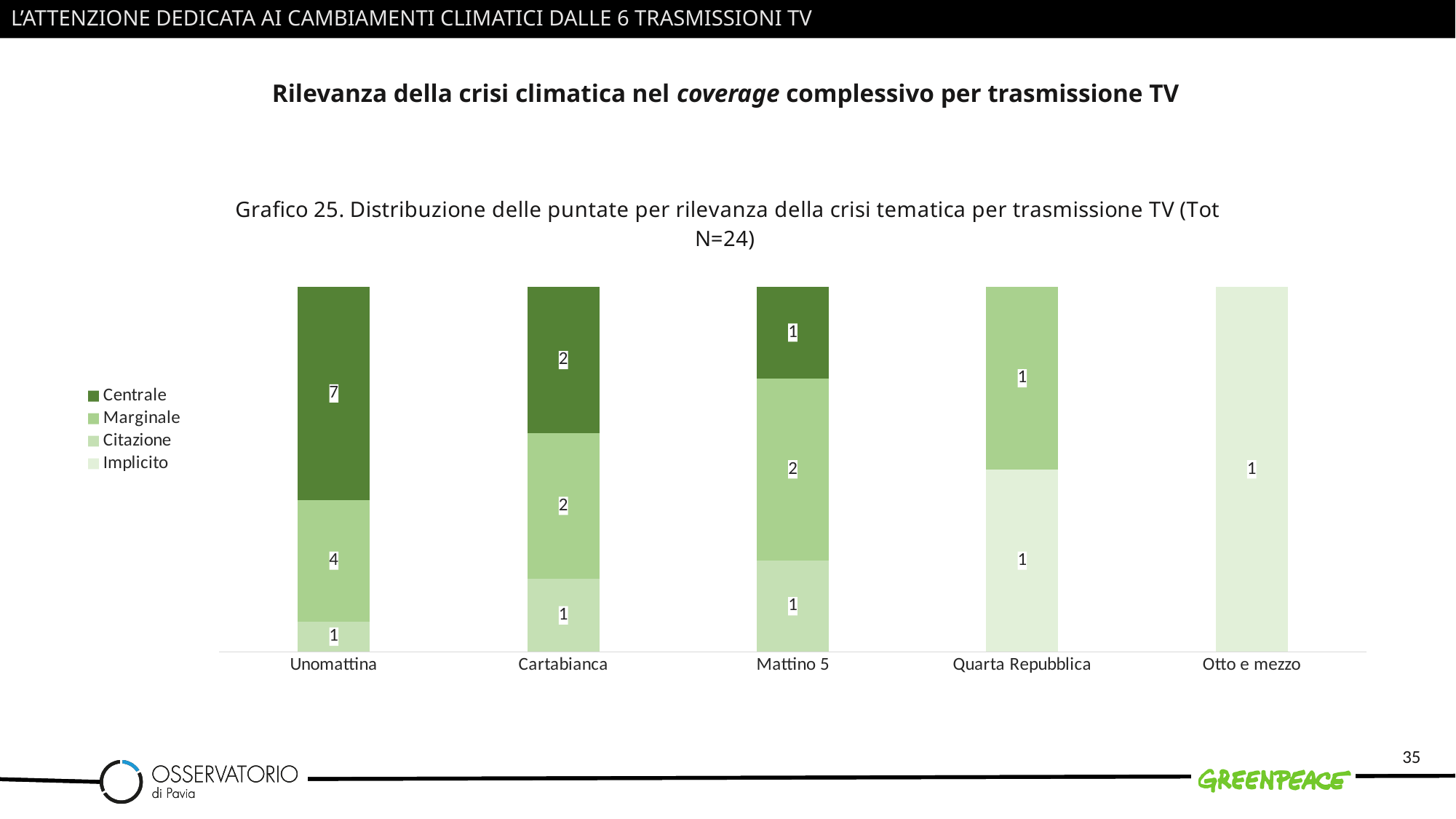
Which is larger, the Marginale value for Unomattina or the Marginale value for Mattino 5? Unomattina What is the Centrale value for Unomattina? 7 What is the total of the stacked bar for Cartabianca? 5 What is the difference between the Centrale values of Unomattina and Cartabianca? 5 How many TV programmes are shown on the x axis? 5 What kind of chart is shown on the slide? Stacked bar chart What is the Marginale value for Cartabianca? 2 Which TV programme has the highest Centrale value? Unomattina How many series does the legend list? 4 What is the Centrale value for Mattino 5? 1 What is the total of the stacked bar for Unomattina? 12 What is the Marginale value for Unomattina? 4